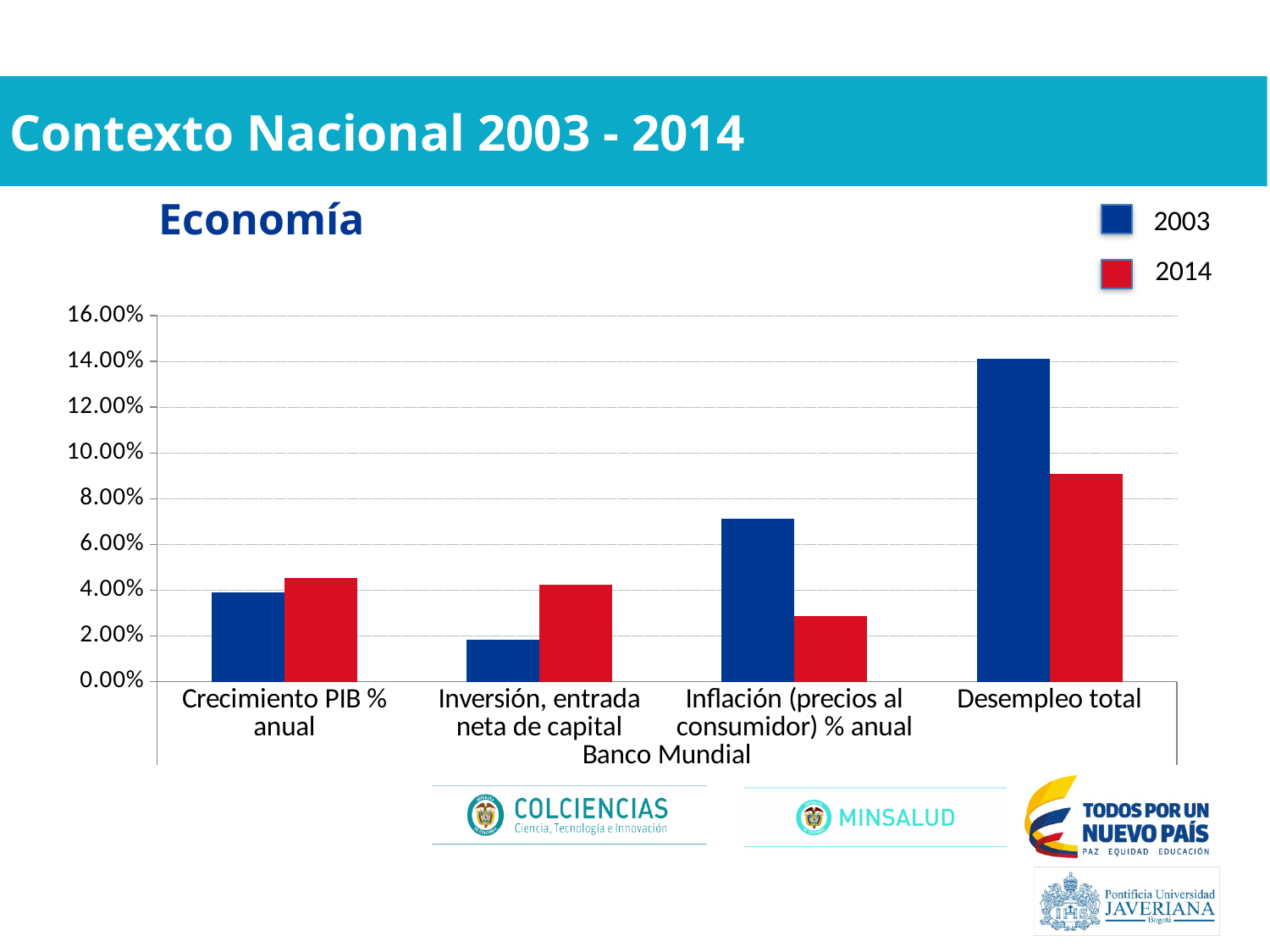
What source label appears below the x axis of the chart? Banco Mundial Which category has the lowest value for 2003? Inversión, entrada neta de capital Which category has the lowest value for 2014? Inflación (precios al consumidor) % anual Is the 2003 value for Inflación (precios al consumidor) % anual greater or less than 6.00%? greater How many categories are shown on the x axis? 4 For Inversión, entrada neta de capital, which year has the larger value, 2003 or 2014? 2014 Is the 2014 value for Inflación (precios al consumidor) % anual greater or less than 4.00%? less What kind of chart is shown on the slide? bar chart Which category has the highest value for 2003? Desempleo total Is the 2003 value for Desempleo total greater or less than 12.00%? greater For Inflación (precios al consumidor) % anual, which year has the larger value, 2003 or 2014? 2003 How many series does the legend list? 2